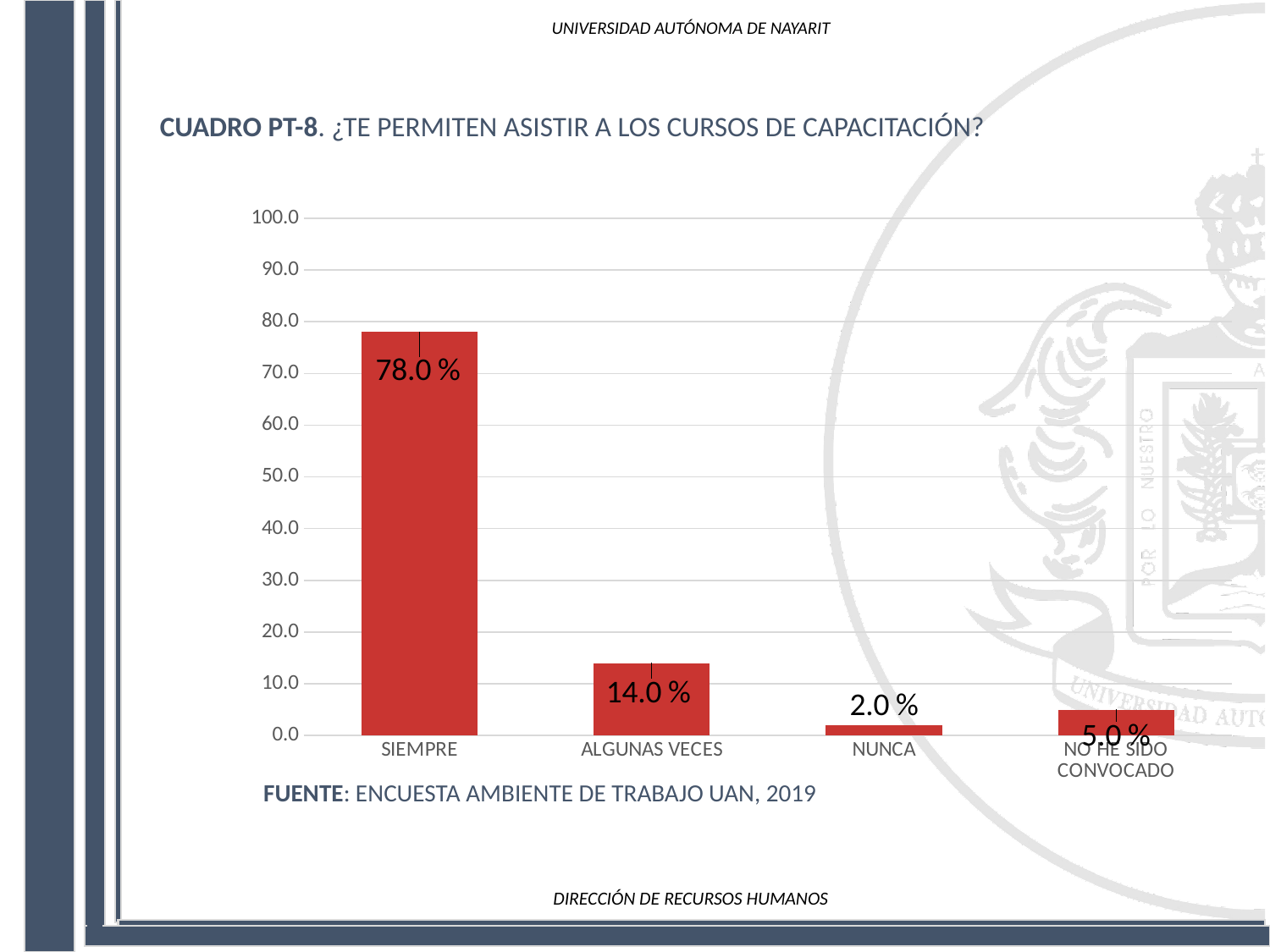
What is the value for SIEMPRE? 78.0 % What is the difference between the values for SIEMPRE and ALGUNAS VECES? 64.0 % Which is larger, the value for NO HE SIDO CONVOCADO or the value for NUNCA? NO HE SIDO CONVOCADO Which category has the highest value? SIEMPRE What is the source cited below the chart? ENCUESTA AMBIENTE DE TRABAJO UAN, 2019 What kind of chart is shown on the slide? bar chart Which category has the lowest value? NUNCA How many categories are shown on the x axis? 4 What is the value for NUNCA? 2.0 % Is the value for SIEMPRE greater or less than 70.0? greater What is the value for NO HE SIDO CONVOCADO? 5.0 % What is the value for ALGUNAS VECES? 14.0 %